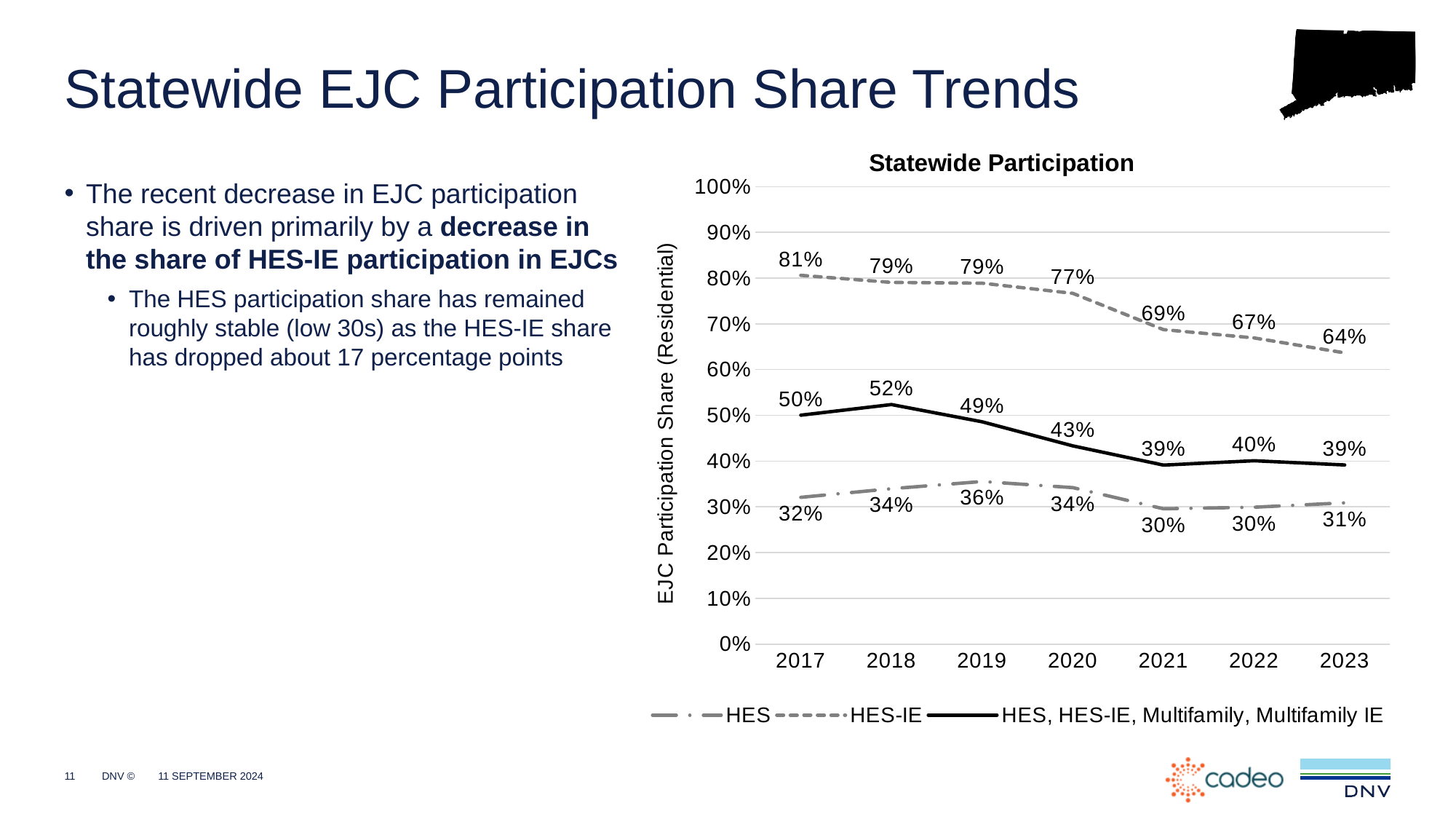
Which is larger in 2021: the HES-IE share or the HES share? HES-IE How many years are shown on the x axis? 7 Is the HES-IE share in 2020 greater or less than 70%? greater How many series does the legend list? 3 In which year is the HES-IE participation share lowest? 2023 In which year is the HES, HES-IE, Multifamily, Multifamily IE series highest? 2018 What is the HES-IE participation share in 2017? 81% What kind of chart is shown on the slide? line chart What is the HES participation share in 2019? 36% Does the HES-IE participation share rise or fall from 2017 to 2023? fall What is the value of the HES, HES-IE, Multifamily, Multifamily IE series in 2020? 43% What is the difference between the HES-IE share in 2017 and in 2023? 17 percentage points